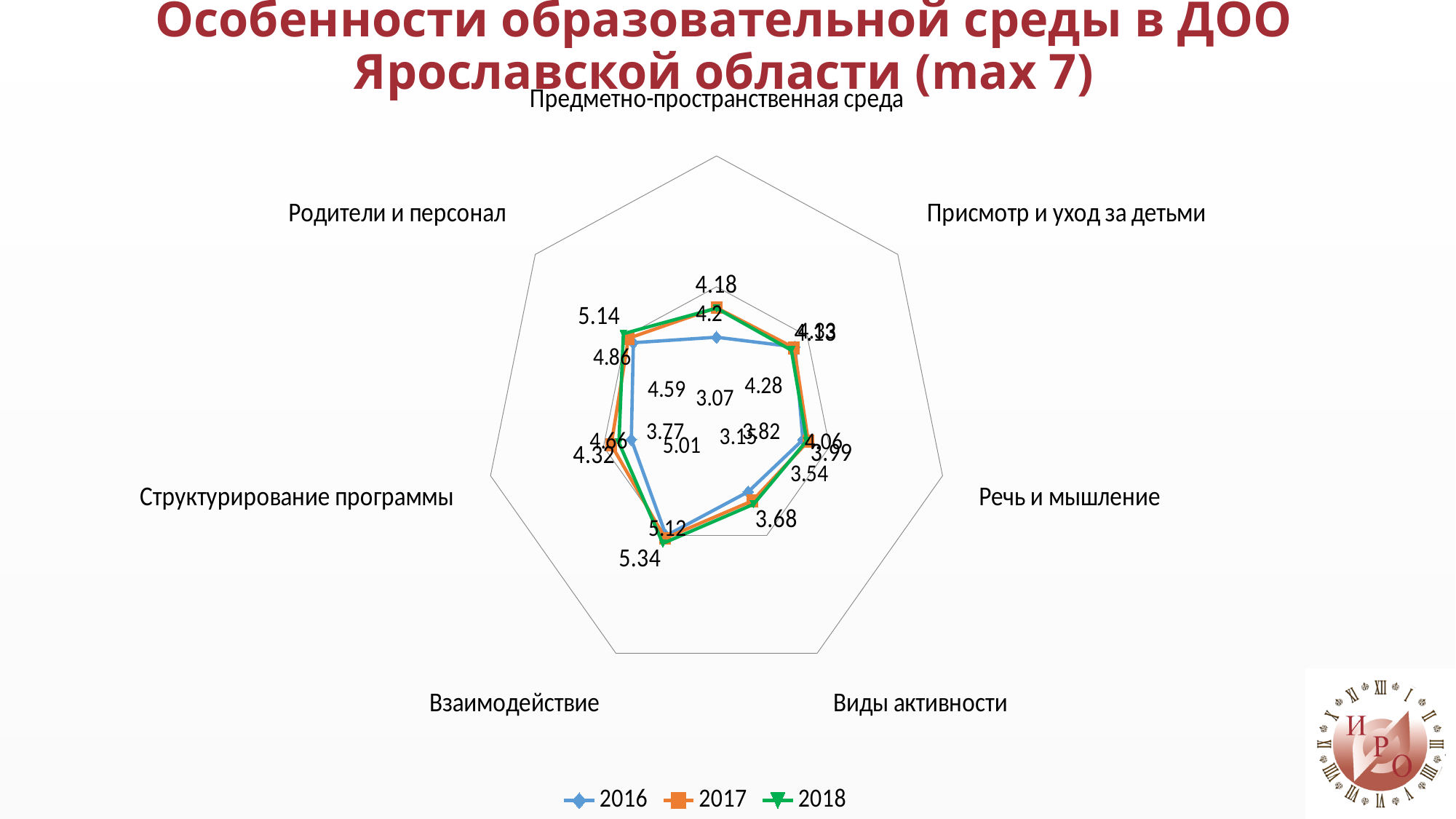
What is the 2016 value for Взаимодействие? 5.01 What is the 2016 value for Родители и персонал? 4.59 What is the 2016 value for Предметно-пространственная среда? 3.07 What kind of chart is shown on the slide? radar chart Which years are listed in the legend? 2016, 2017, 2018 What is the maximum possible score indicated in the chart title? 7 How many series does the legend list? 3 How many categories (axes) does the radar chart have? 7 What is the 2016 value for Виды активности? 3.15 What is the 2016 value for Структурирование программы? 3.77 What is the highest value labelled anywhere on the chart, and for which category? 5.34, Взаимодействие For 2016, which is larger: the value for Взаимодействие or the value for Виды активности? Взаимодействие